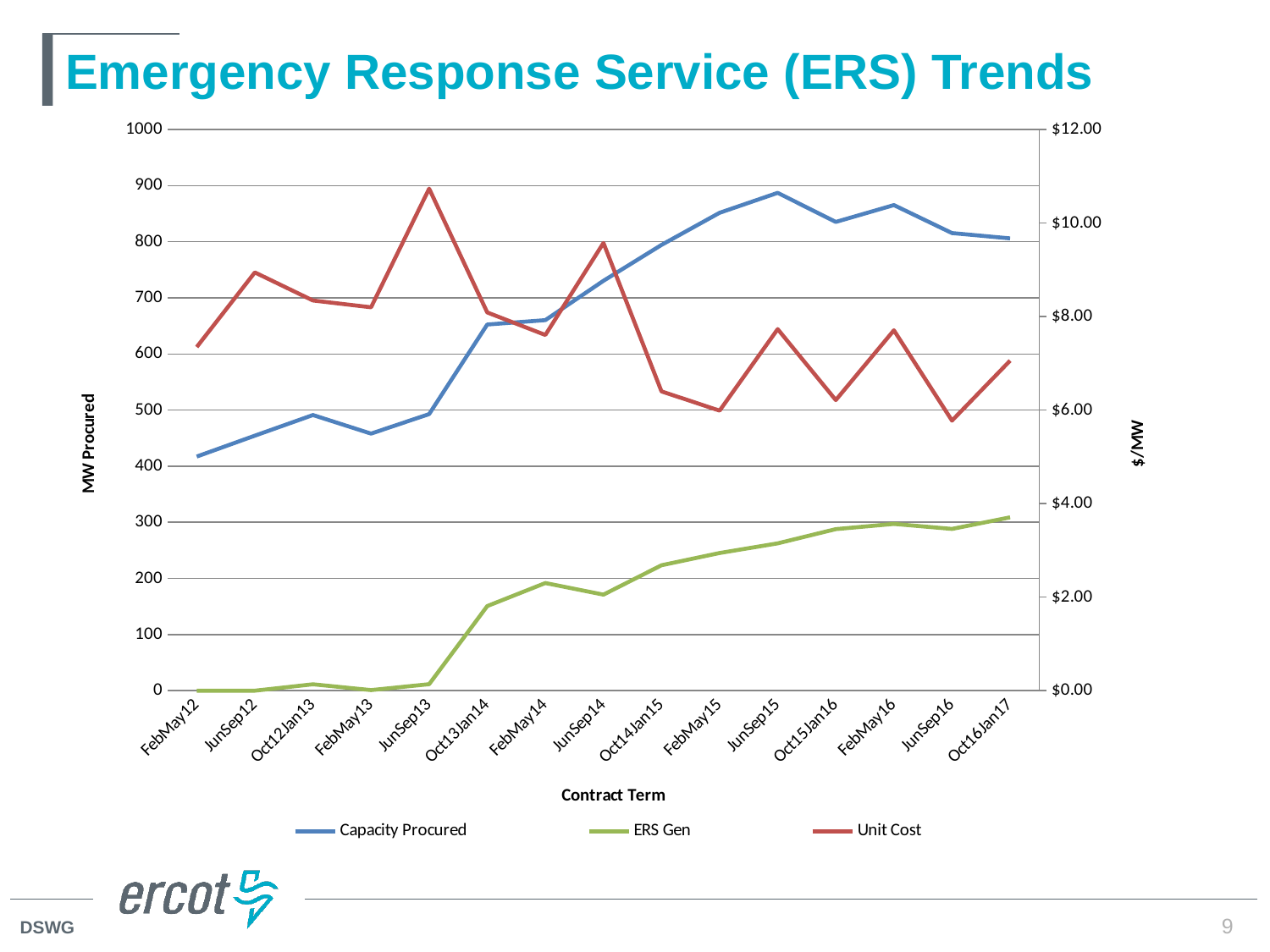
Which contract term has the highest Unit Cost? JunSep13 Is the ERS Gen value for Oct13Jan14 greater or less than 100? greater What is the title of the right-hand vertical axis? $/MW Which contract term has the lowest Capacity Procured? FebMay12 Is the Capacity Procured for JunSep15 greater or less than 800? greater How many contract terms are plotted along the x axis? 15 Which is larger, the Capacity Procured for Oct16Jan17 or for FebMay12? Oct16Jan17 What kind of chart is shown on the slide? Line chart Is the Capacity Procured for FebMay12 greater or less than 500? less How many series does the legend list? 3 Does the ERS Gen series generally rise or fall from FebMay12 to Oct16Jan17? rise